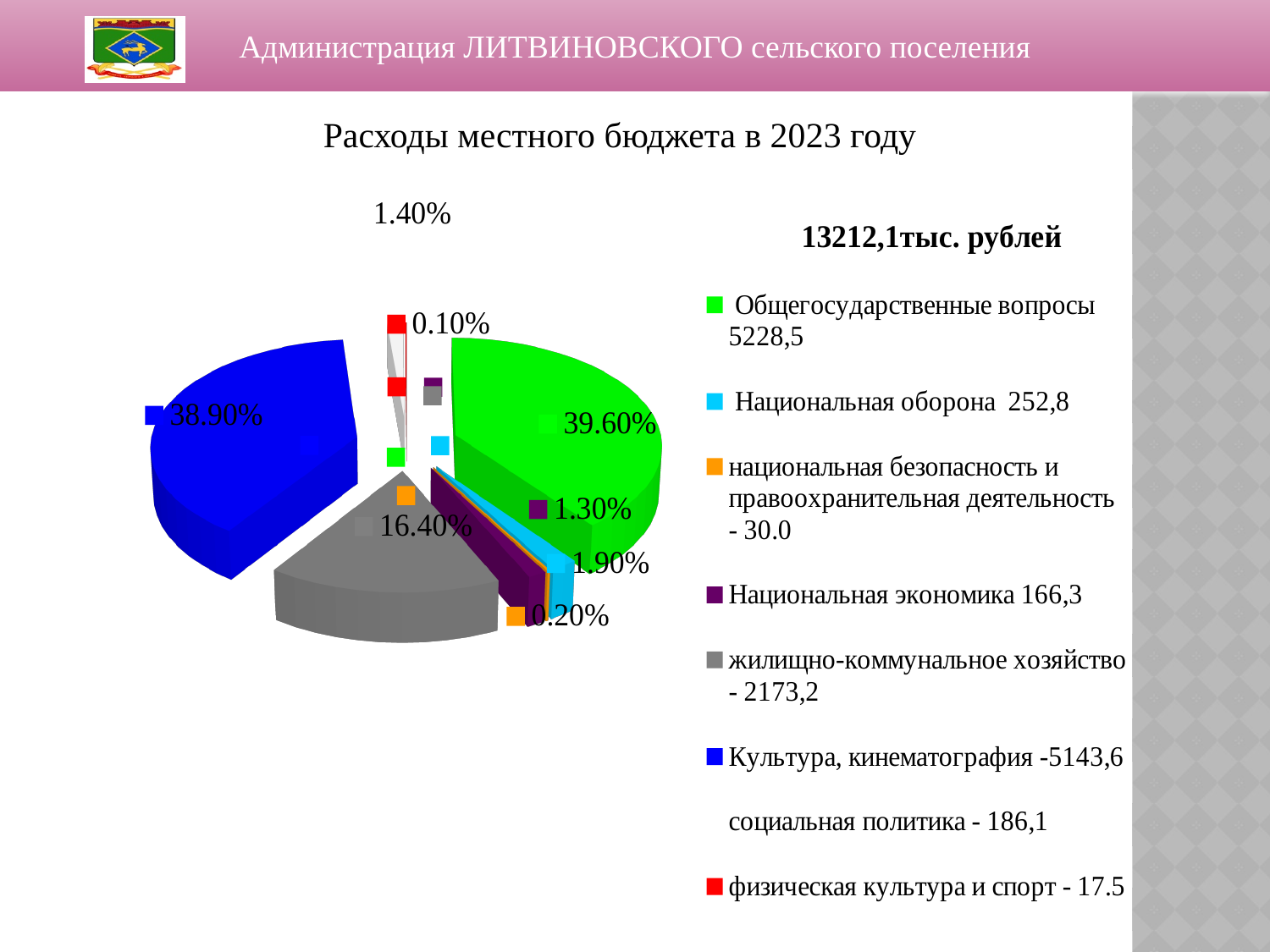
What is the difference in percentage points between the shares of Общегосударственные вопросы and жилищно-коммунальное хозяйство? 23.20% Which share is larger: Общегосударственные вопросы or Культура, кинематография? Общегосударственные вопросы How many categories does the legend list? 8 What is the title of the chart? 13212,1тыс. рублей What total amount of expenditure is stated on the slide? 13212,1тыс. рублей Which category has the largest share of the pie? Общегосударственные вопросы What percentage share is shown for Национальная оборона? 1.90% What percentage share is shown for Культура, кинематография? 38.90% What value is given in the legend for Национальная экономика? 166,3 What percentage share is shown for жилищно-коммунальное хозяйство? 16.40% Which category has the smallest share of the pie? физическая культура и спорт What kind of chart is shown on the slide? pie chart